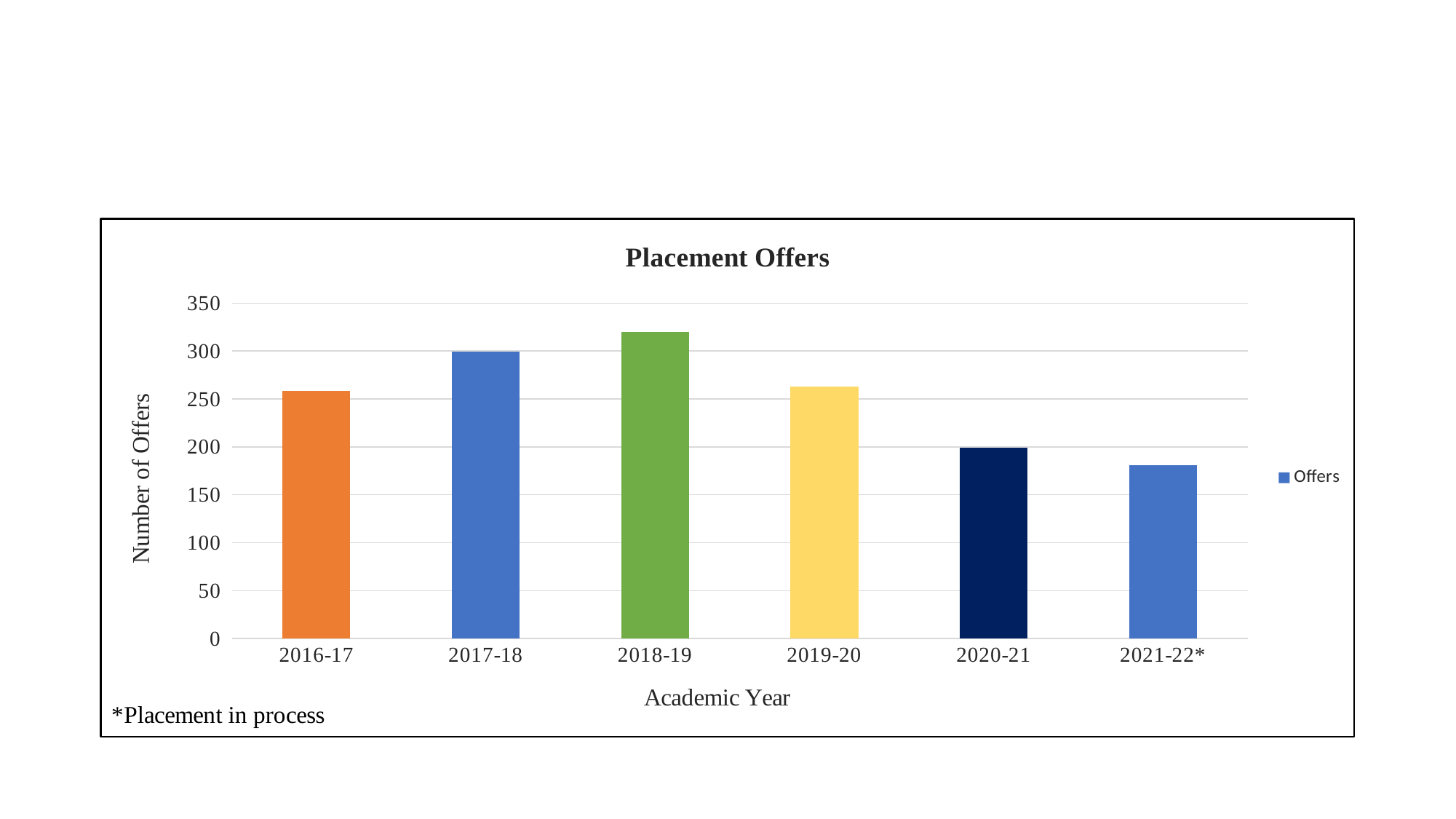
What is the label on the y axis of the chart? Number of Offers Is the value for 2016-17 greater or less than 300? less What kind of chart is shown on the slide? bar chart What is the title of the chart? Placement Offers Do the values rise or fall from 2018-19 to 2021-22*? fall Is the value for 2018-19 greater or less than 300? greater Is the value for 2021-22* greater or less than 200? less Which academic year has the highest number of offers? 2018-19 Which has more offers, 2017-18 or 2016-17? 2017-18 How many series does the legend list? 1 How many academic years are shown on the x axis of the chart? 6 Which academic year has the lowest number of offers? 2021-22*